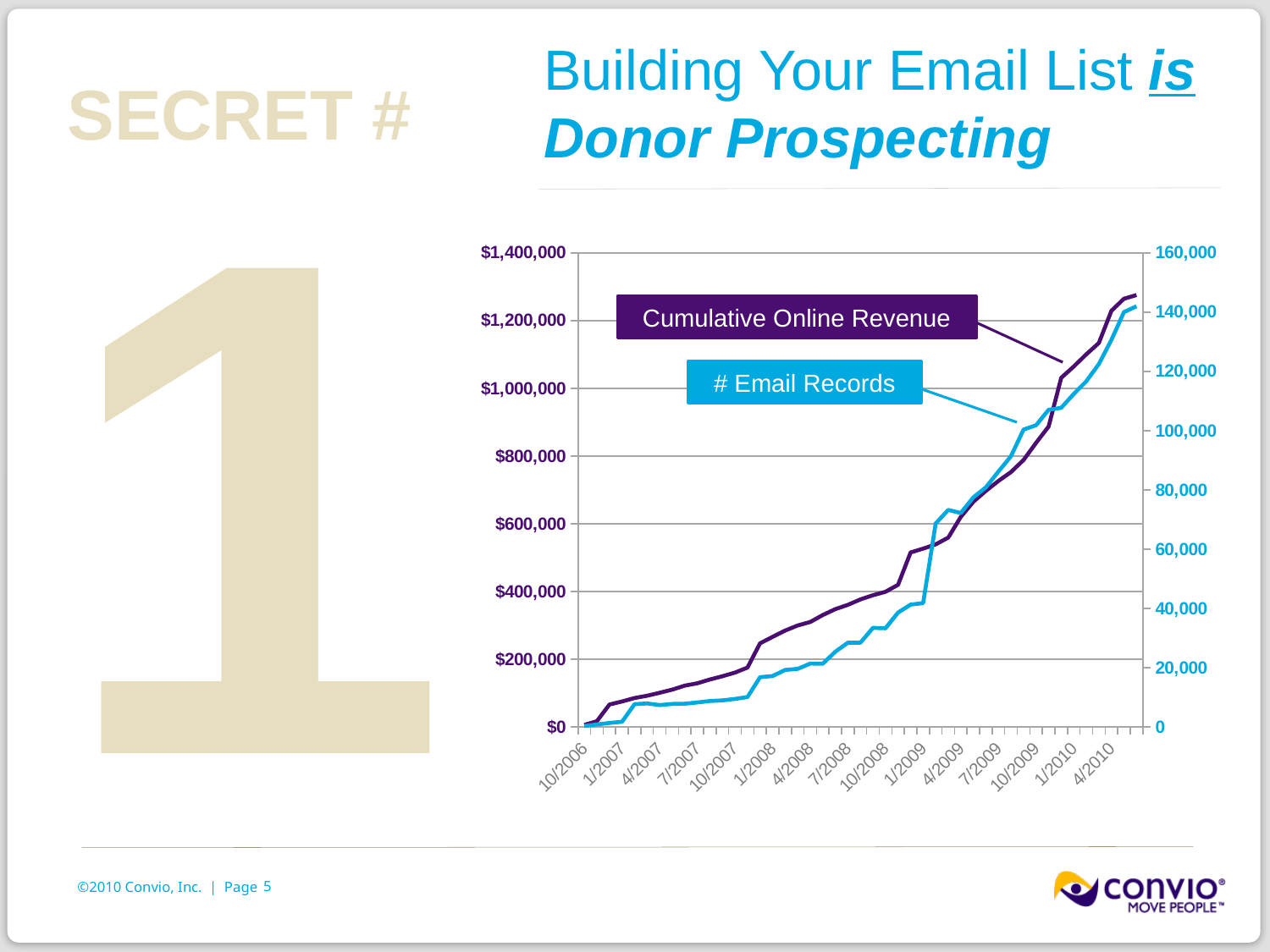
How many date labels are shown along the x axis? 15 What are the names of the two series plotted on the chart? Cumulative Online Revenue and # Email Records What kind of chart is shown on the slide? line chart What colour is the Cumulative Online Revenue line? purple Is the Cumulative Online Revenue value at 4/2010 greater or less than $1,000,000? greater Is the # Email Records value at 10/2007 greater or less than 20,000? less How many data series are plotted on the chart? 2 Is the # Email Records value at 4/2009 greater or less than 60,000? greater Does the Cumulative Online Revenue line rise or fall from 10/2006 to 4/2010? rise Does the # Email Records line rise or fall over the period shown? rise